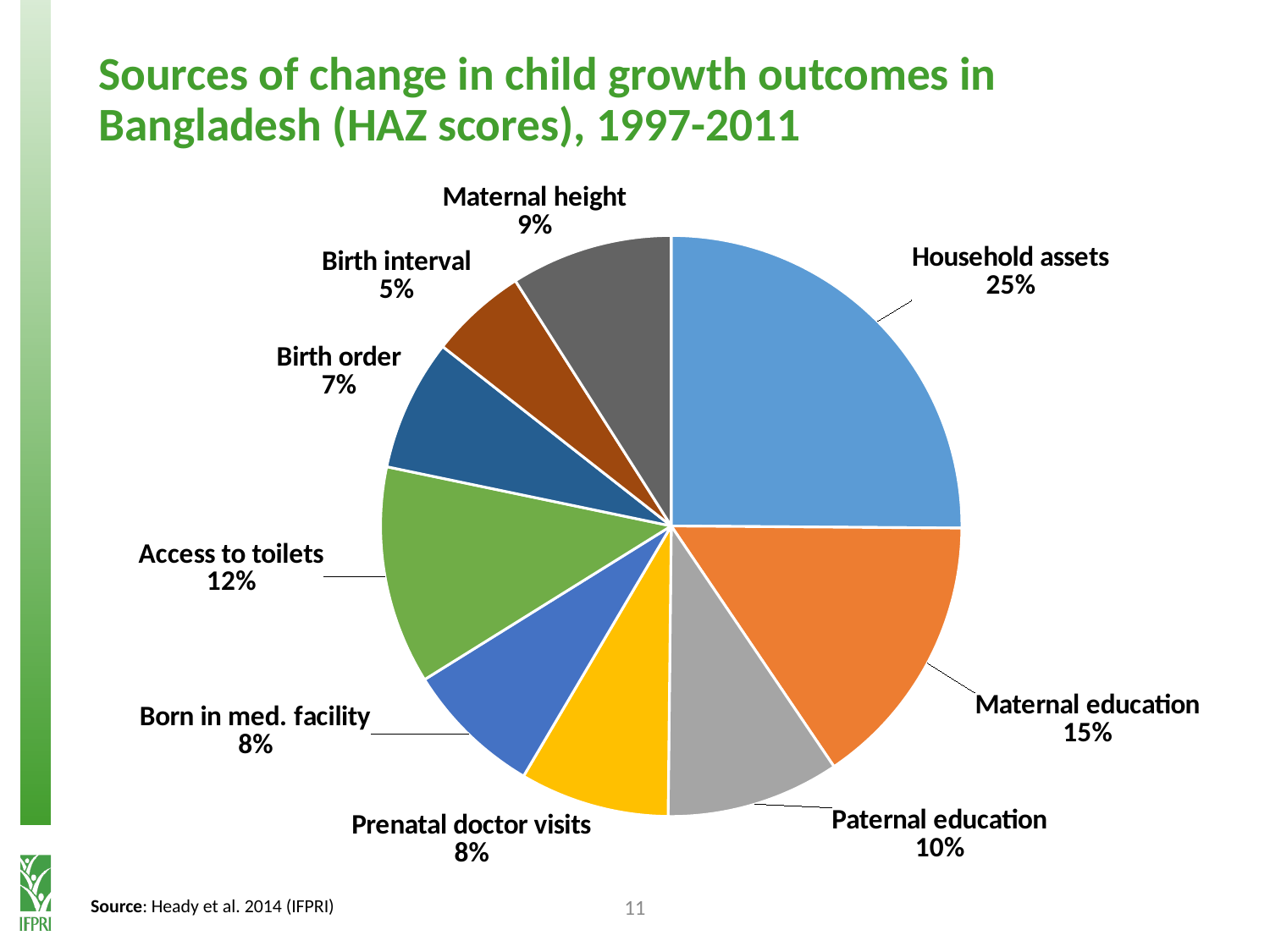
What share of the change is attributed to Birth interval? 5% What kind of chart is shown on the slide? pie chart What is the difference in percentage points between Access to toilets and Birth order? 5 What is the title of the chart? Sources of change in child growth outcomes in Bangladesh (HAZ scores), 1997-2011 What share of the change is attributed to Maternal education? 15% How many slices does the pie chart have? 9 Which is larger, the share for Paternal education or the share for Maternal height? Paternal education What is the difference in percentage points between Household assets and Maternal education? 10 Which source accounts for the largest share of the change? Household assets What share of the change is attributed to Access to toilets? 12% What share of the change is attributed to Household assets? 25% Which source accounts for the smallest share of the change? Birth interval